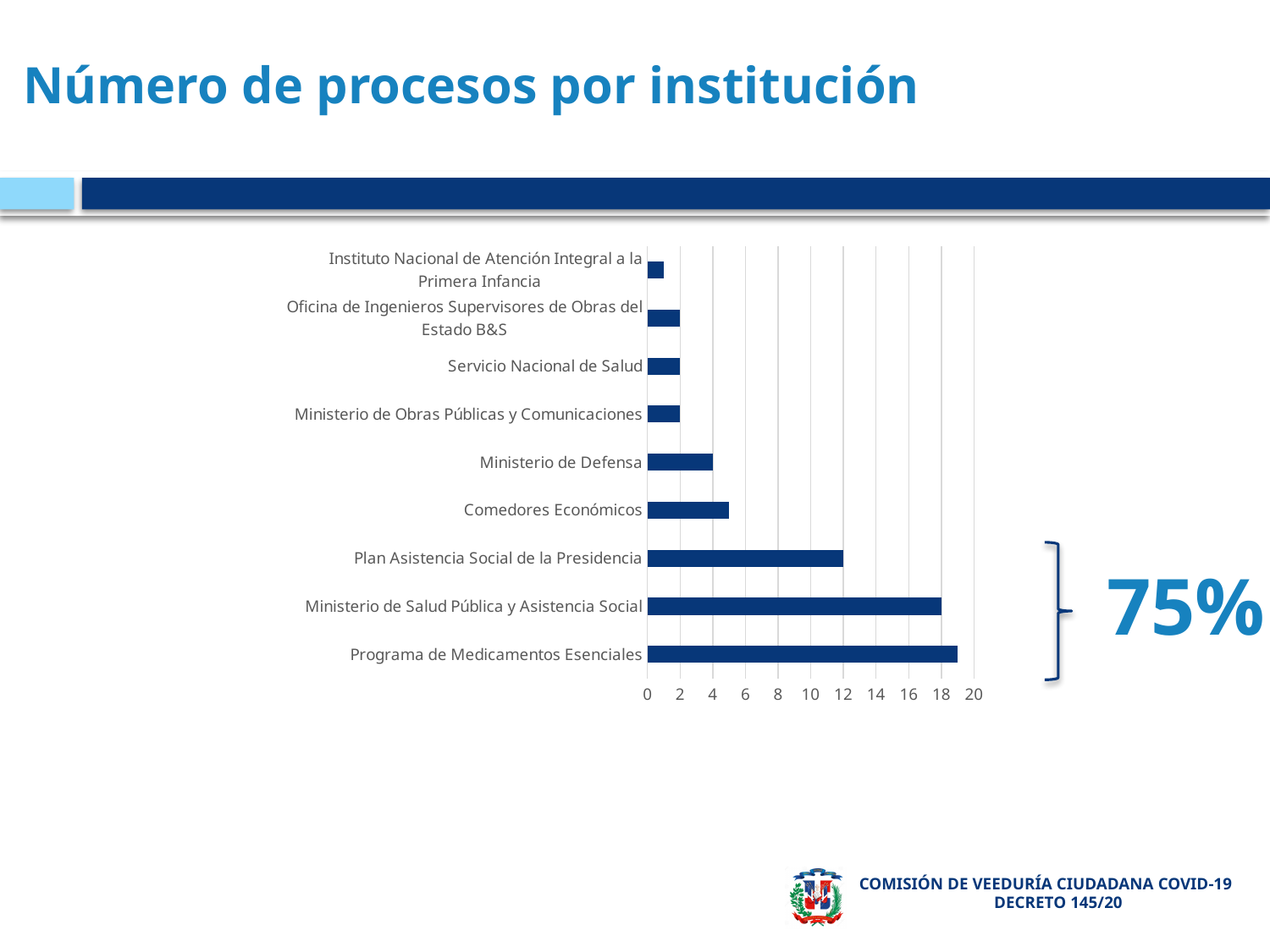
Which institution has the highest number of processes? Programa de Medicamentos Esenciales How many processes does Ministerio de Salud Pública y Asistencia Social have? 18 What is the difference between the number of processes for Ministerio de Salud Pública y Asistencia Social and Plan Asistencia Social de la Presidencia? 6 What kind of chart is shown on the slide? bar chart Is the value for Comedores Económicos greater or less than 4? greater Which has more processes, Plan Asistencia Social de la Presidencia or Ministerio de Salud Pública y Asistencia Social? Ministerio de Salud Pública y Asistencia Social How many processes does Plan Asistencia Social de la Presidencia have? 12 How many processes does Ministerio de Defensa have? 4 How many institutions are listed in the chart? 9 Which institution has the lowest number of processes? Instituto Nacional de Atención Integral a la Primera Infancia What percentage is shown next to the bracket grouping the three largest bars? 75% Is the value for Programa de Medicamentos Esenciales greater or less than 18? greater